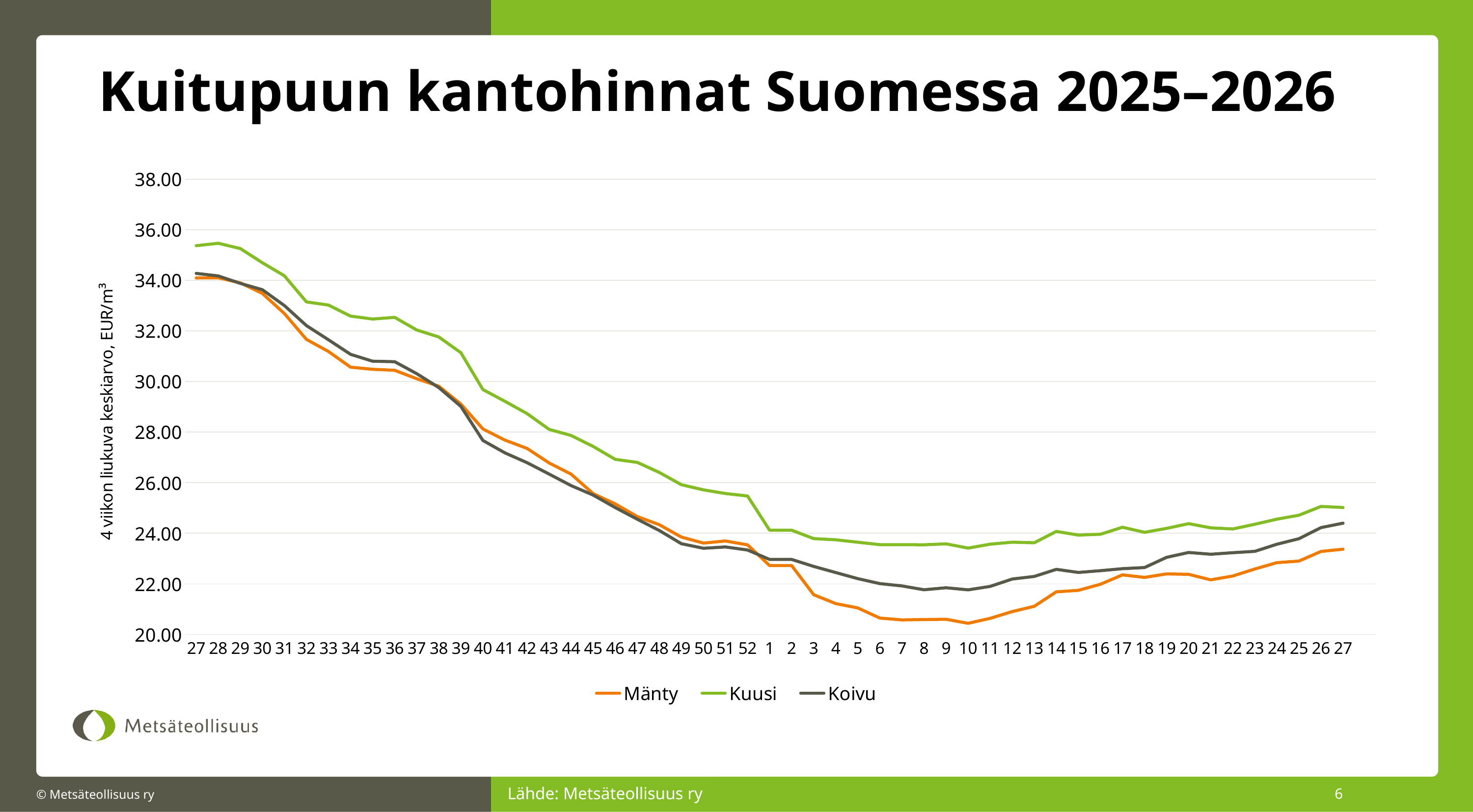
What kind of chart is shown on the slide? line chart Which series are listed in the legend? Mänty, Kuusi, Koivu Is the value for Mänty at week 10 greater or less than 22.00? less What is the title of the chart? Kuitupuun kantohinnat Suomessa 2025–2026 Which series has the highest value at week 40? Kuusi At week 10, which is larger, the value for Koivu or the value for Mänty? Koivu How many series does the legend list? 3 Is the value for Kuusi at the first week 27 greater or less than 34.00? greater Which series has the lowest value at week 20? Mänty Does the Mänty line rise or fall from week 27 to week 10? fall Is the value for Kuusi at week 52 greater or less than 24.00? greater How many week points are plotted along the x axis? 53